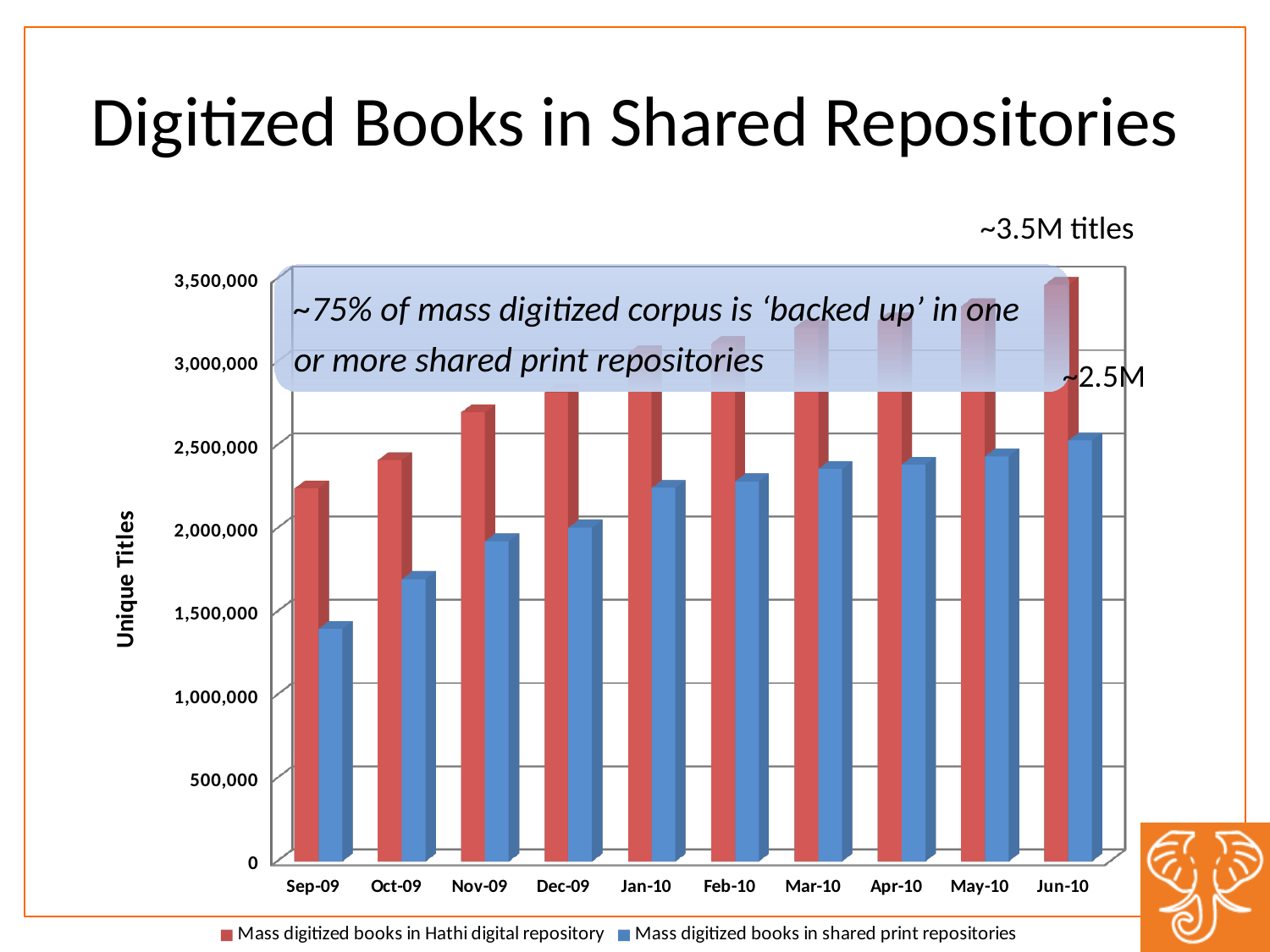
Which colour represents Mass digitized books in Hathi digital repository in the chart? red In which month is the value for Mass digitized books in shared print repositories lowest? Sep-09 What kind of chart is shown on the slide? bar chart How many series does the chart's legend list? 2 Is the value for Mass digitized books in shared print repositories in Sep-09 greater or less than 1,500,000? less Is the value for Mass digitized books in shared print repositories in Jan-10 greater or less than 2,000,000? greater In which month is the value for Mass digitized books in Hathi digital repository highest? Jun-10 How many months are shown along the x axis of the chart? 10 In Jan-10, which is larger: Mass digitized books in Hathi digital repository or Mass digitized books in shared print repositories? Mass digitized books in Hathi digital repository Do the values for Mass digitized books in shared print repositories rise or fall from Sep-09 to Jun-10? rise Is the value for Mass digitized books in Hathi digital repository in Jun-10 greater or less than 3,000,000? greater What is the title of the chart's vertical axis? Unique Titles